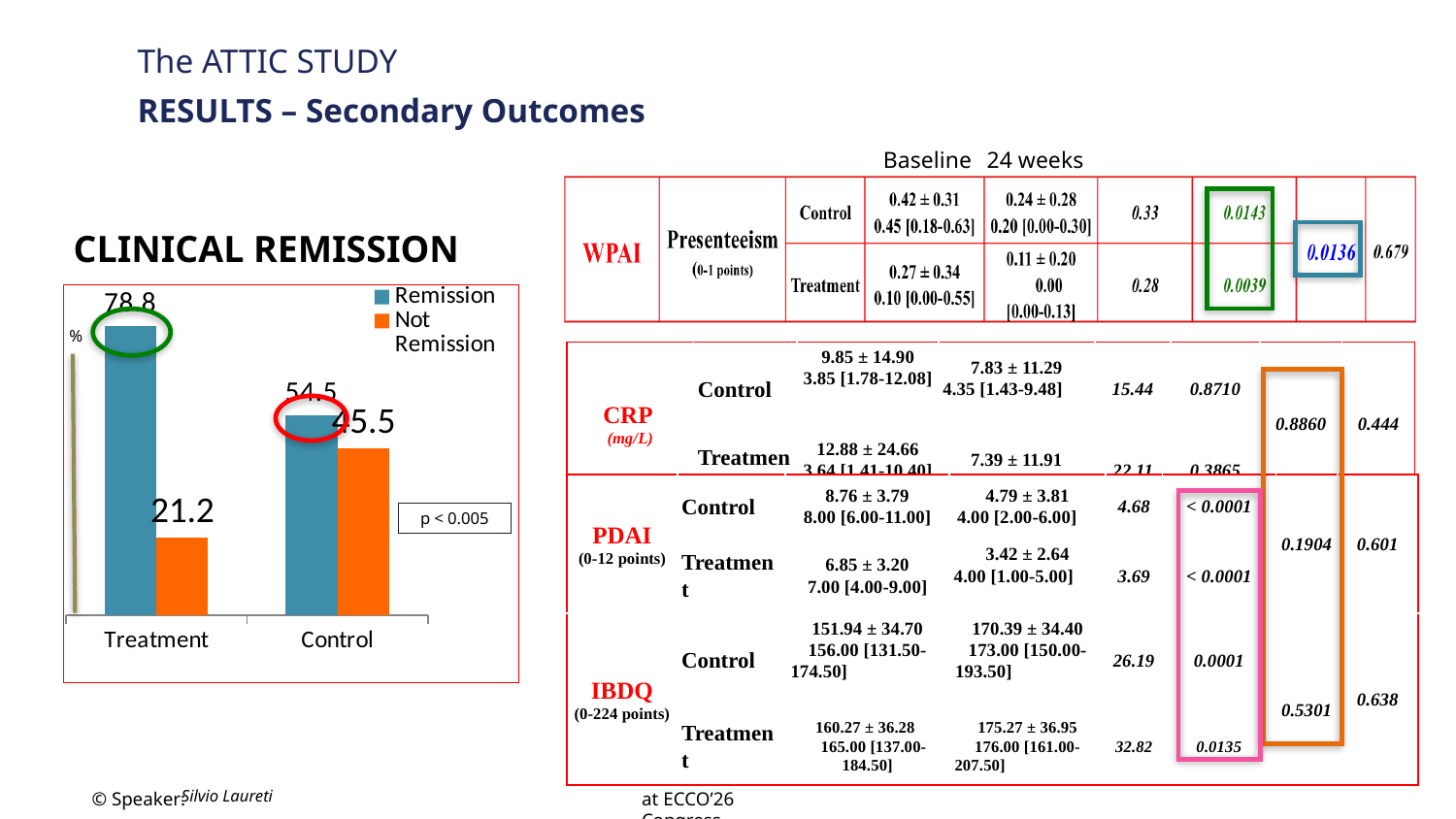
What is the Not Remission value for Treatment in the Clinical Remission chart? 21.2 How many groups are shown on the x axis of the Clinical Remission chart? 2 Which group has the lower Not Remission value in the Clinical Remission chart? Treatment Which group has the higher Remission value in the Clinical Remission chart? Treatment What is the Not Remission value for Control in the Clinical Remission chart? 45.5 How many series does the legend of the Clinical Remission chart list? 2 In the Clinical Remission chart, is the Not Remission value for Control larger or smaller than the Not Remission value for Treatment? larger What is the Remission value for Control in the Clinical Remission chart? 54.5 What type of chart is the Clinical Remission chart? Bar chart What is the Remission value for Treatment in the Clinical Remission chart? 78.8 What p-value is annotated on the Clinical Remission chart? p < 0.005 What is the difference between the Remission values for Treatment and Control in the Clinical Remission chart? 24.3